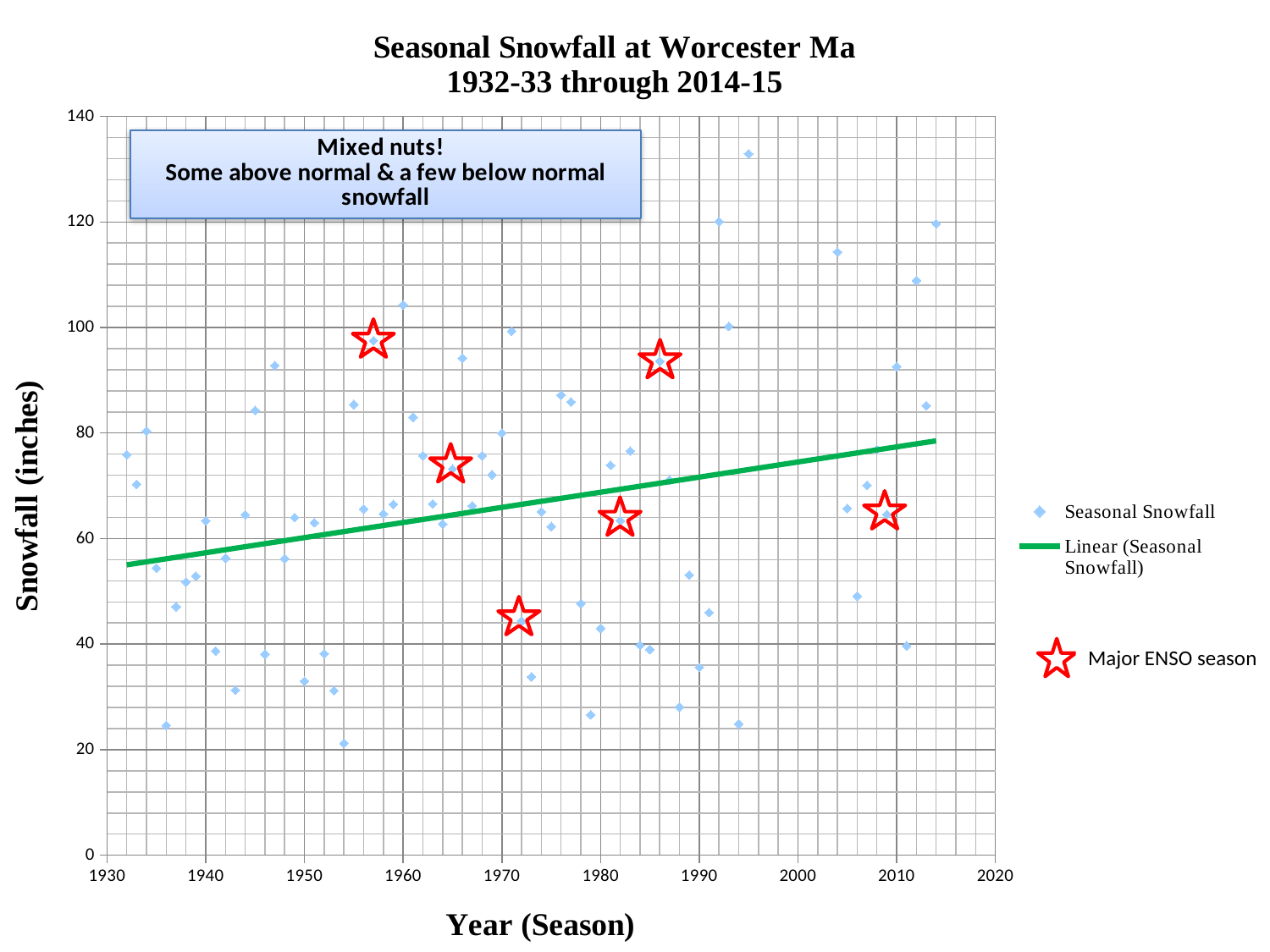
Is the snowfall value plotted around 1936 greater or less than 40? less Is the highest plotted snowfall value (around 1995) greater or less than 120? greater What is the label of the y axis? Snowfall (inches) How many Major ENSO season star markers are shown on the chart? 6 Is the snowfall value plotted around 2004 greater or less than 100? greater What is the title of the chart? Seasonal Snowfall at Worcester Ma 1932-33 through 2014-15 How many series does the legend list? 2 What kind of chart is shown on the slide? scatter chart Does the linear trend line rise or fall from 1930 to 2020? rise